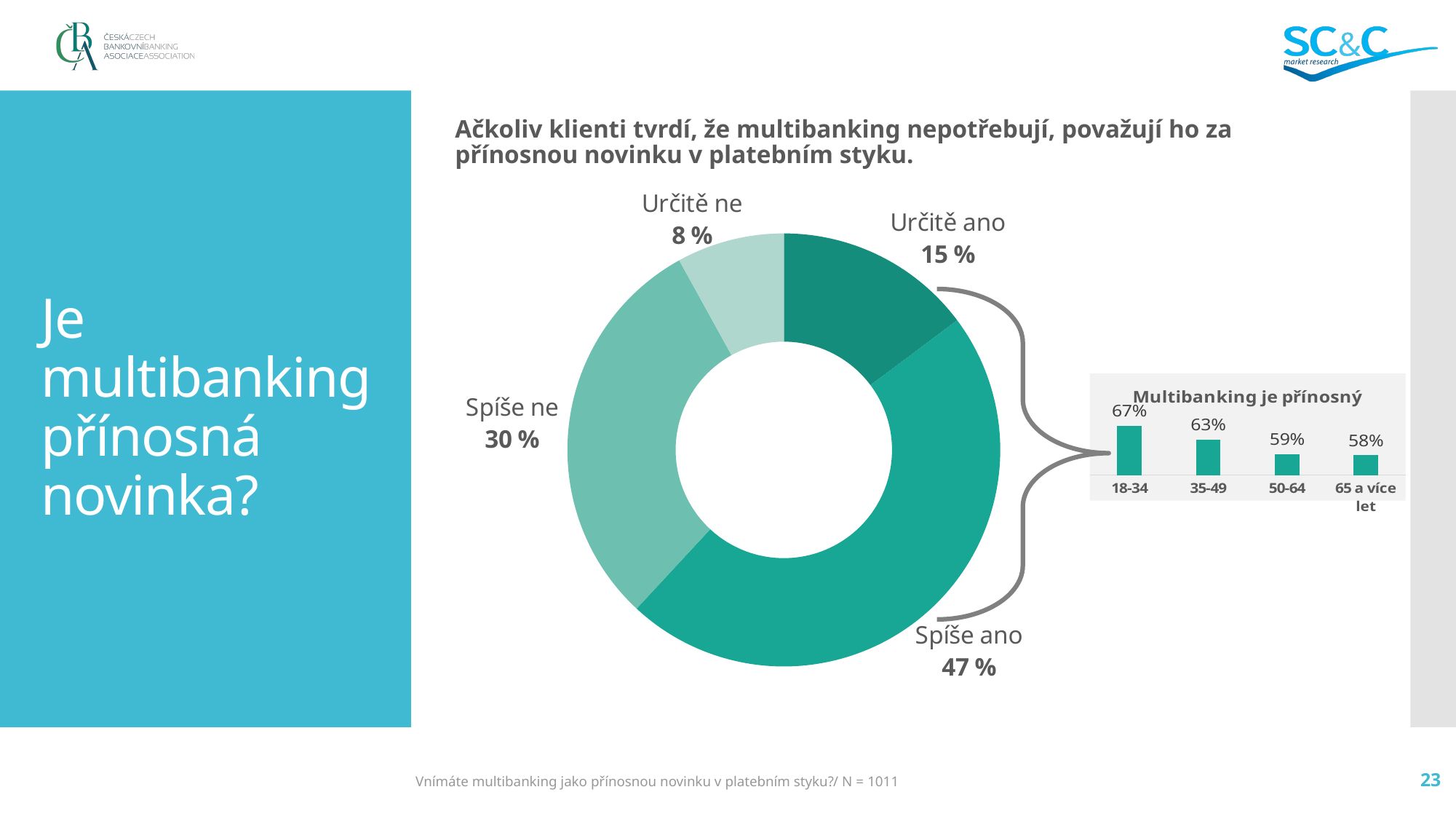
In the donut chart, how many percentage points larger is "Spíše ne" than "Určitě ano"? 15 In the donut chart, what share of respondents answered "Spíše ano"? 47 % In the bar chart "Multibanking je přínosný", which age group has the lowest value? 65 a více let In the bar chart "Multibanking je přínosný", what is the difference between the 35-49 and 50-64 age groups? 4 percentage points In the donut chart, what share of respondents answered "Určitě ne"? 8 % In the donut chart, which answer has the largest share? Spíše ano In the bar chart "Multibanking je přínosný", do the values rise or fall from the youngest to the oldest age group? Fall In the donut chart, what is the combined share of "Určitě ano" and "Spíše ano"? 62 % In the bar chart "Multibanking je přínosný", what is the value for the 18-34 age group? 67% In the donut chart, which answer has the smallest share? Určitě ne What kind of chart is the large chart in the centre of the slide? Donut (pie) chart How many slices does the donut chart have? 4